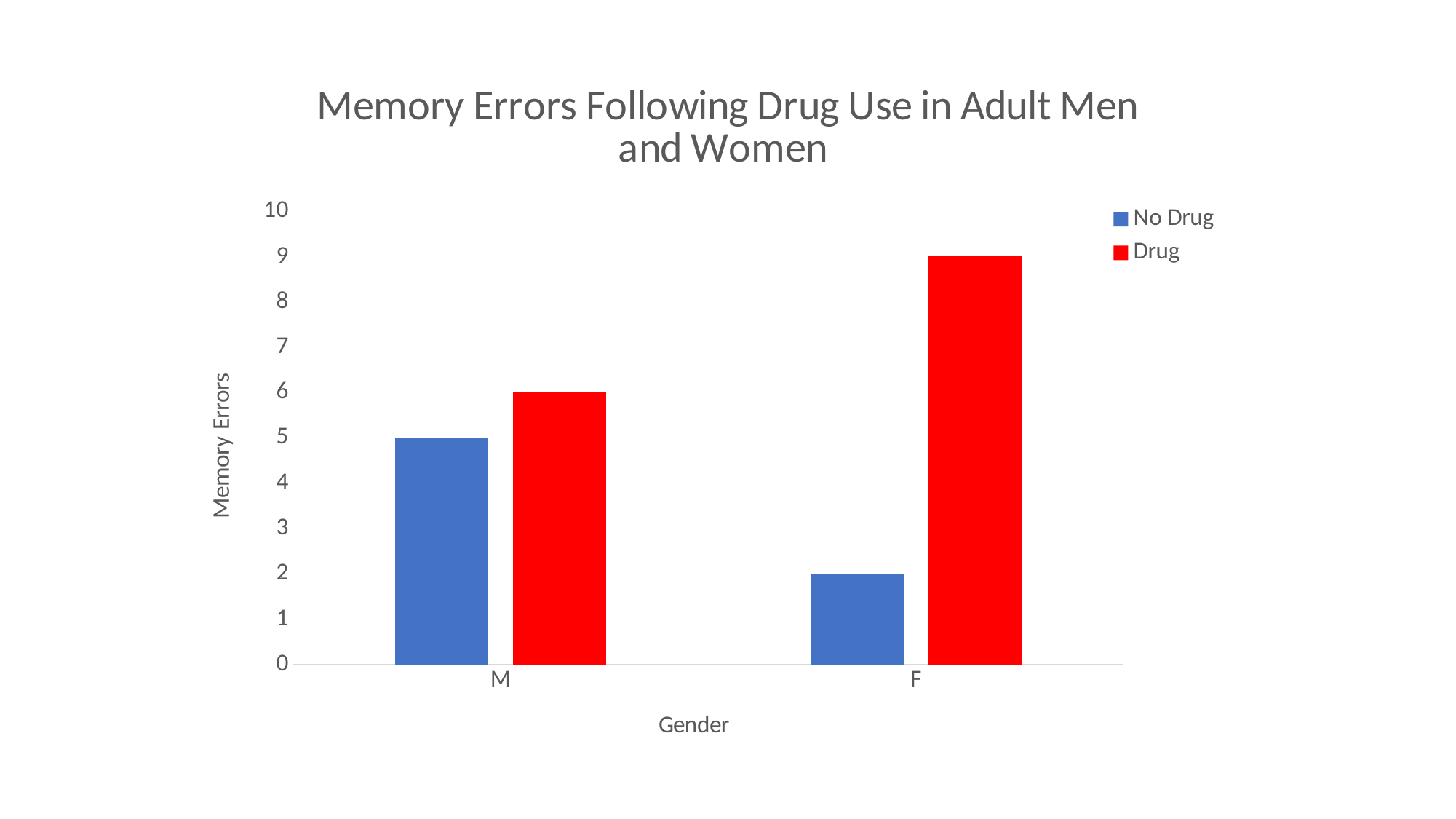
Which is larger for M: the Drug value or the No Drug value? Drug Which gender has the highest Drug value? F What is the difference between the Drug and No Drug values for F? 7 Is the Drug value for F greater or less than 8? greater How many series does the legend list? 2 What is the value for No Drug for F? 2 What is the value for Drug for F? 9 What is the value for Drug for M? 6 How many categories are shown on the x axis? 2 What kind of chart is shown on the slide? bar chart What is the value for No Drug for M? 5 Which gender has the lowest No Drug value? F